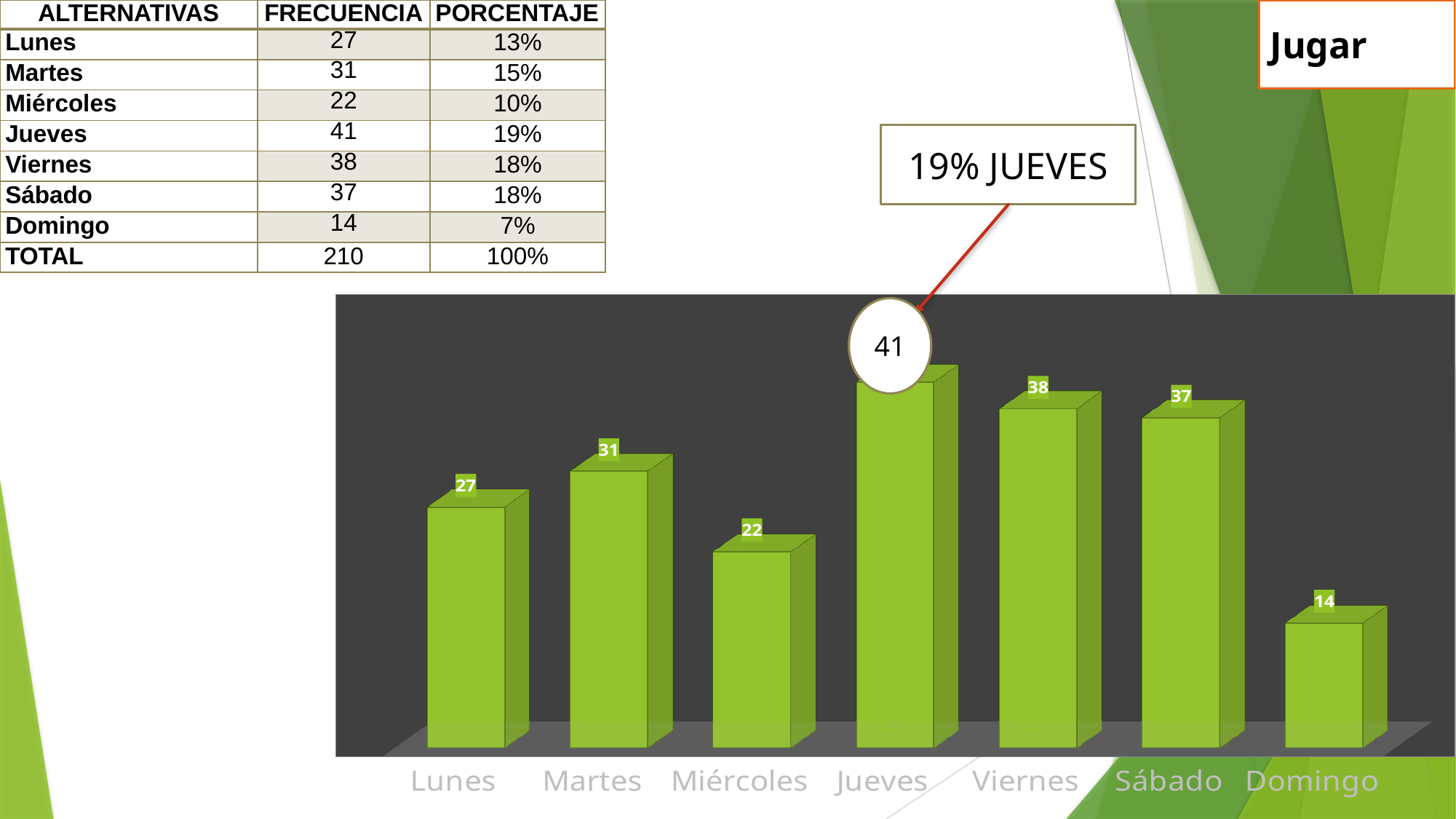
What is the value for Miércoles in the bar chart? 22 How many categories are shown on the x axis of the bar chart? 7 Which day has the highest bar in the chart? Jueves What is the difference between the values for Martes and Lunes? 4 What is the total of all the bar values in the chart? 210 What is the value for Domingo in the bar chart? 14 What percentage does the callout above the Jueves bar state? 19% Which day has the lowest bar in the chart? Domingo What is the value for Jueves in the bar chart? 41 What kind of chart is shown on the slide? bar chart Which is larger, the value for Viernes or the value for Miércoles? Viernes What is the difference between the values for Jueves and Domingo? 27